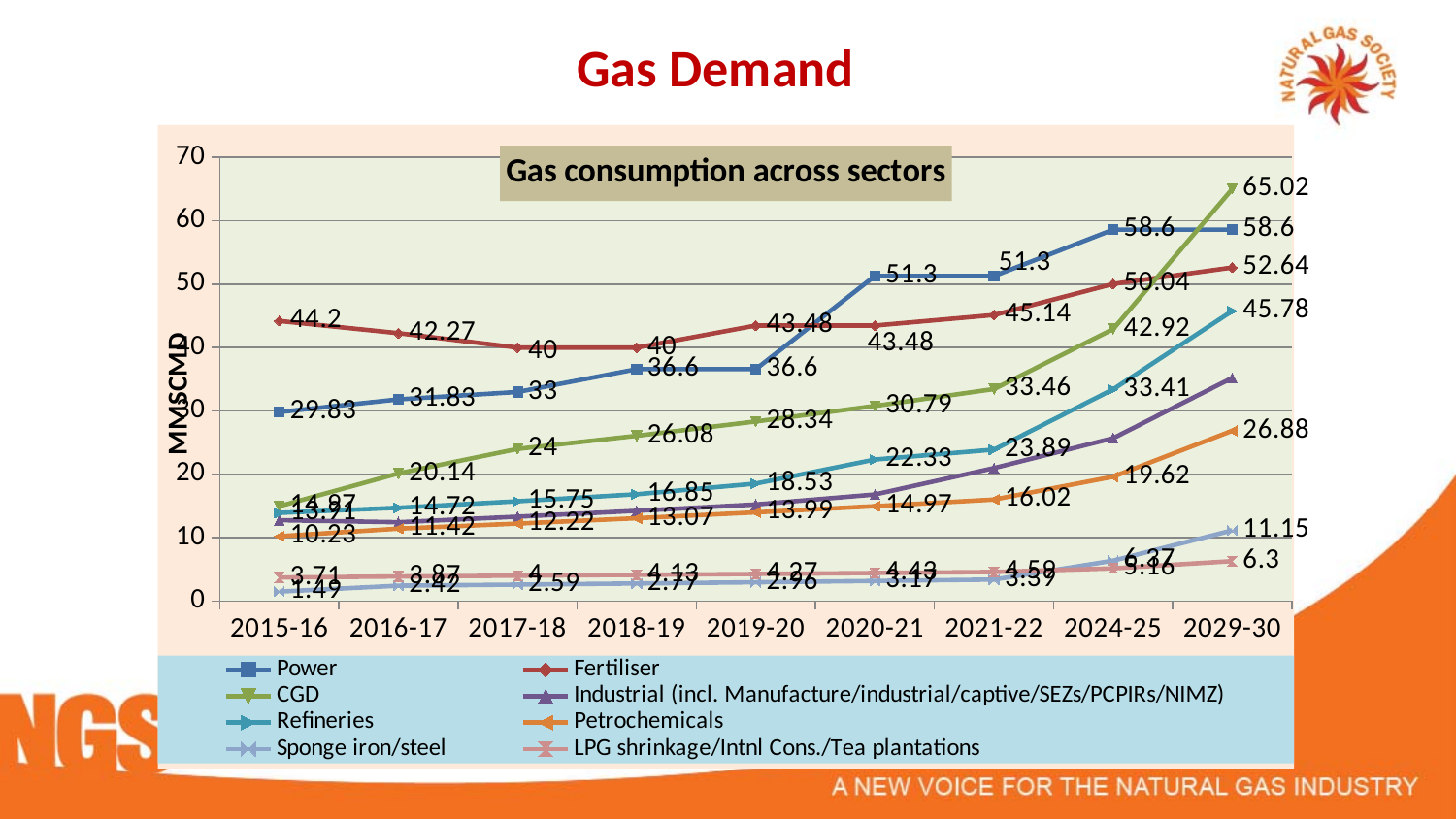
In 2015-16, which is larger: Fertiliser or Power? Fertiliser How many series does the legend list? 8 What is the CGD value for 2029-30? 65.02 Is the Industrial value for 2029-30 greater or less than 30? greater What is the Sponge iron/steel value for 2029-30? 11.15 What is the difference between the CGD and Power values in 2029-30? 6.42 How many time periods are shown on the x axis? 9 Which sector has the highest value in 2029-30? CGD What kind of chart is this? line chart What is the Power value for 2029-30? 58.6 What is the Refineries value for 2029-30? 45.78 What is the Fertiliser value for 2015-16? 44.2